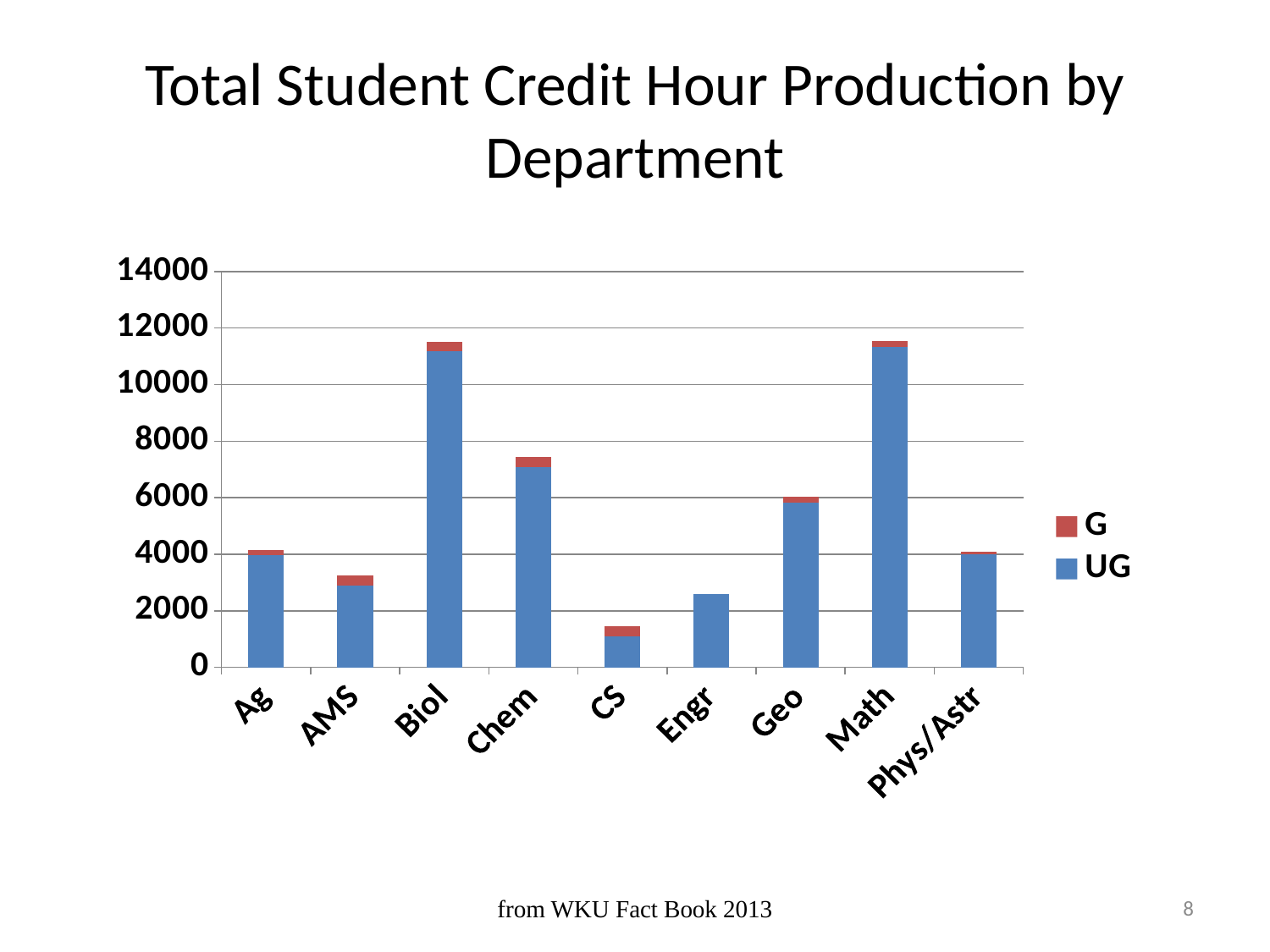
Is the total value for AMS greater or less than 4000? less What kind of chart is shown on the slide? stacked bar chart Is the total value for Biol greater or less than 10000? greater Is the total value for CS greater or less than 2000? less Which has a larger total, Engr or Phys/Astr? Phys/Astr Which series is shown in blue in the legend? UG Which has a larger total, Chem or Geo? Chem How many departments are shown on the x axis? 9 Which department has the lowest total student credit hour production? CS How many series does the legend list? 2